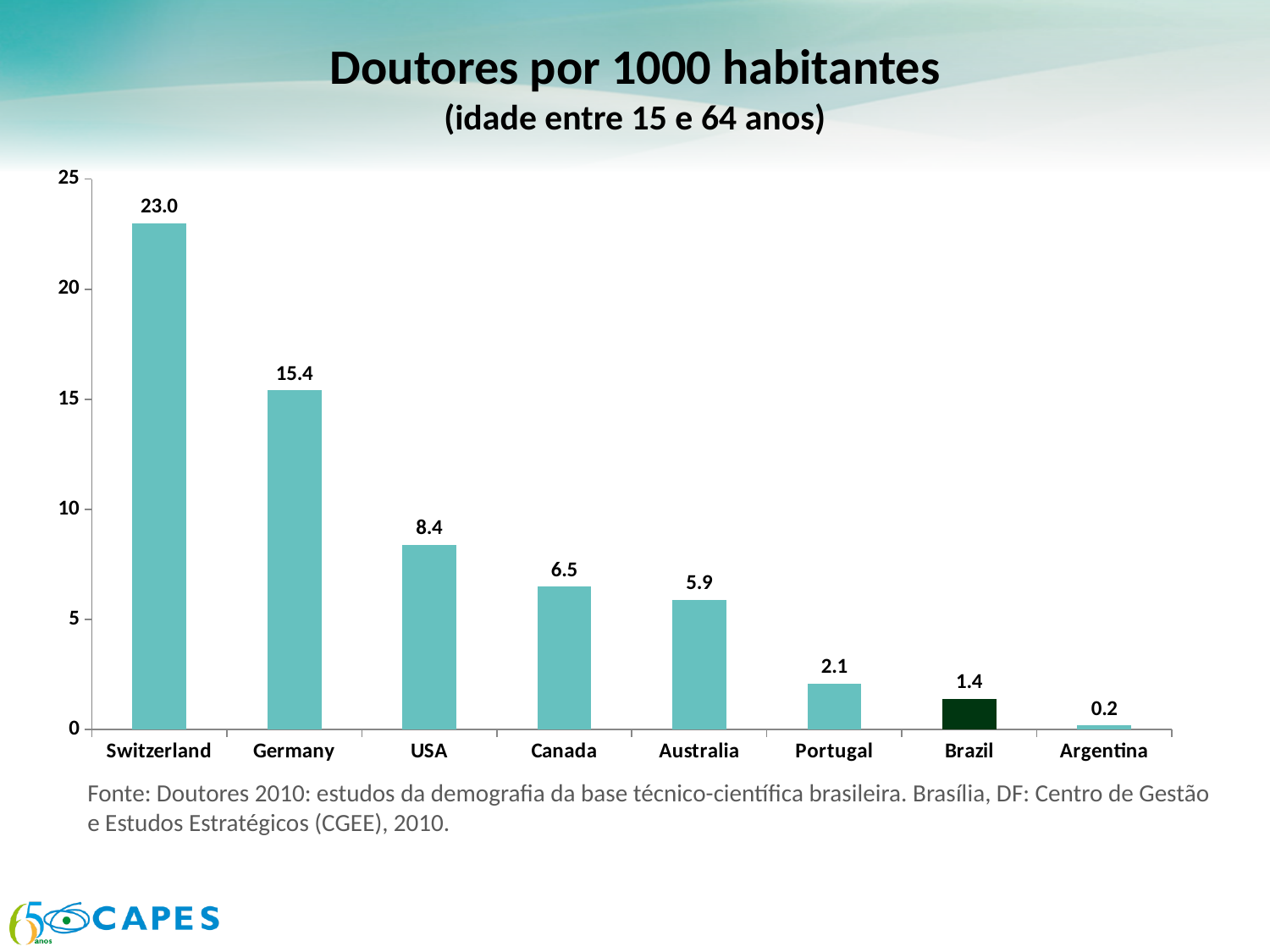
What is the value for Canada? 6.5 What is the difference between the values for Portugal and Brazil? 0.7 Which is larger, the value for USA or the value for Australia? USA What is the value for Switzerland? 23.0 What is the value for Brazil? 1.4 How many countries are shown on the chart? 8 What kind of chart is shown on the slide? bar chart Which country has the lowest value? Argentina What is the difference between the values for Switzerland and Germany? 7.6 Is the value for Germany greater or less than 15? greater Which country's bar is shown in a different (dark green) colour from the others? Brazil Which country has the highest value? Switzerland